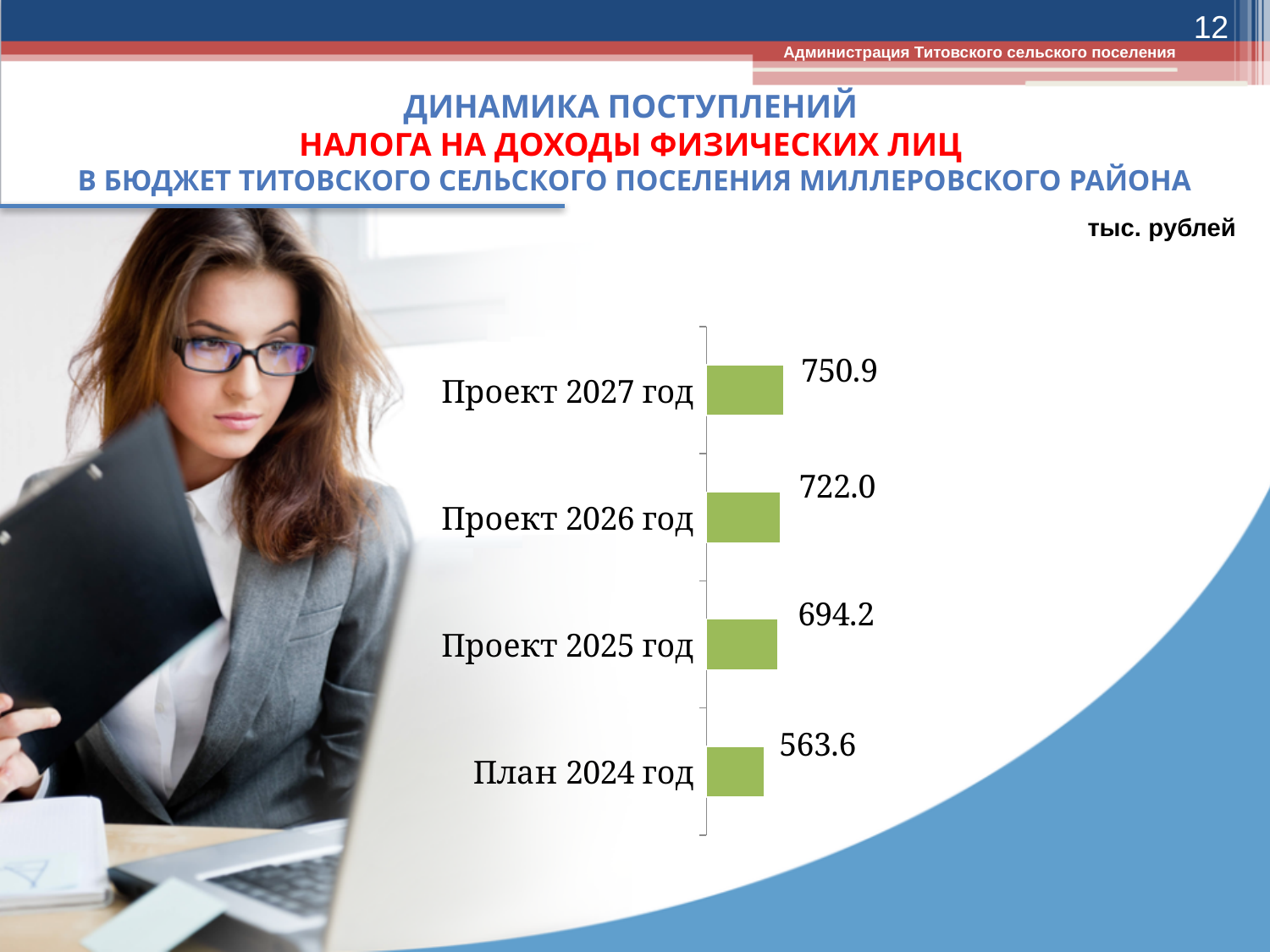
What is the value for План 2024 год? 563.6 What kind of chart is shown on the slide? Bar chart Which category has the highest value? Проект 2027 год Which category has the lowest value? План 2024 год What is the difference between the values for Проект 2027 год and План 2024 год? 187.3 What is the value for Проект 2025 год? 694.2 What is the value for Проект 2026 год? 722.0 What is the difference between the values for Проект 2026 год and Проект 2025 год? 27.8 Which is larger, the value for Проект 2025 год or the value for План 2024 год? Проект 2025 год How many categories are shown in the chart? 4 What is the value for Проект 2027 год? 750.9 In what units are the chart values given, according to the slide? тыс. рублей